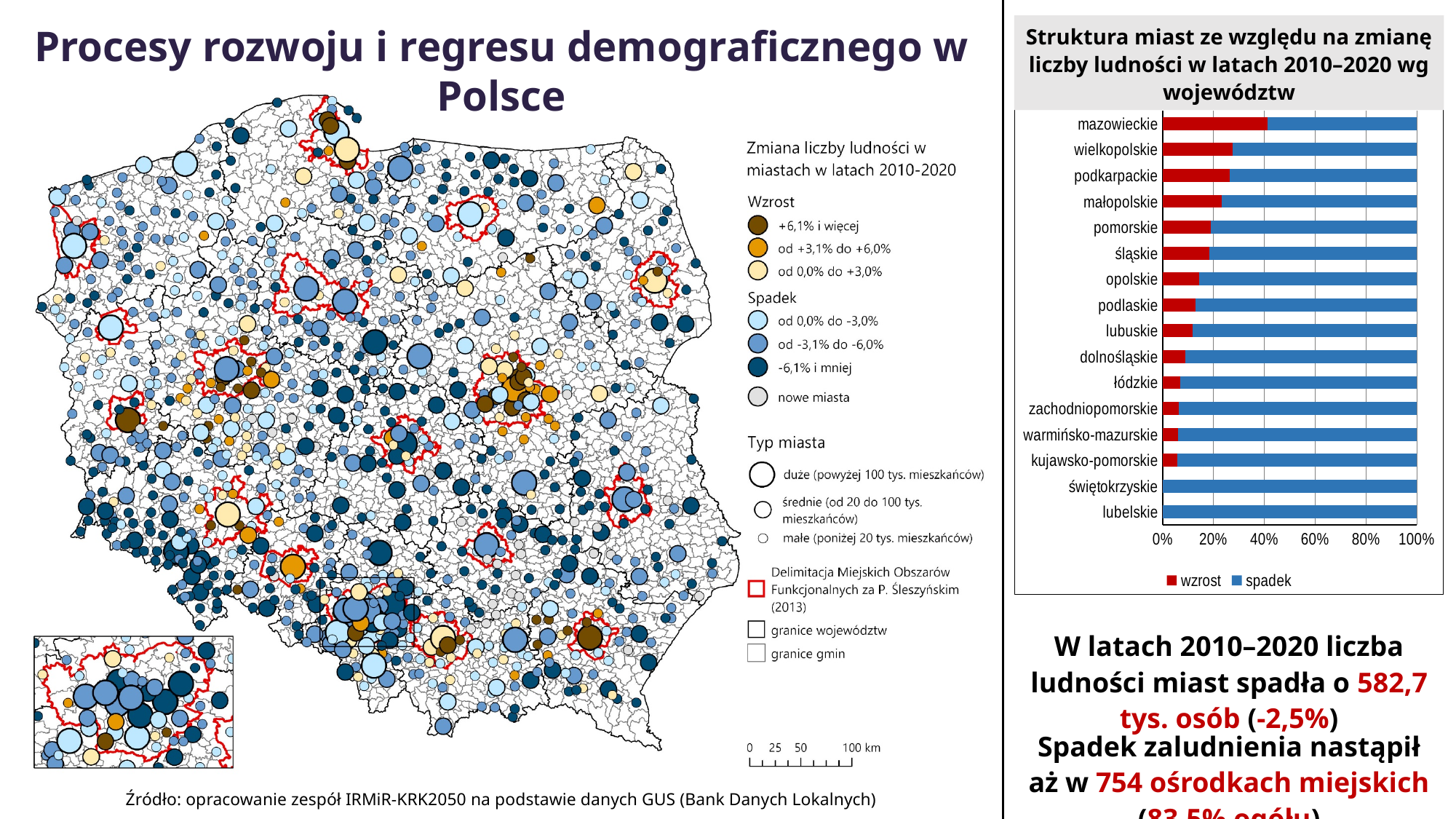
Which has a larger 'wzrost' share: mazowieckie or małopolskie? mazowieckie Is the 'wzrost' share for mazowieckie greater or less than 20%? greater How many voivodeships (categories) are shown in the bar chart? 16 How many series does the legend of the bar chart list? 2 Is the 'wzrost' share for wielkopolskie greater or less than 40%? less Which voivodeship has the largest share of 'wzrost' in the bar chart? mazowieckie What is the total of the stacked bar for mazowieckie? 100% What are the two legend entries of the bar chart? wzrost, spadek Going from the top category (mazowieckie) to the bottom (lubelskie), does the 'wzrost' share rise or fall? fall Is the 'spadek' share for łódzkie greater or less than 80%? greater Which has a larger 'spadek' share: lubelskie or mazowieckie? lubelskie What kind of chart is shown on the right side of the slide? stacked bar chart